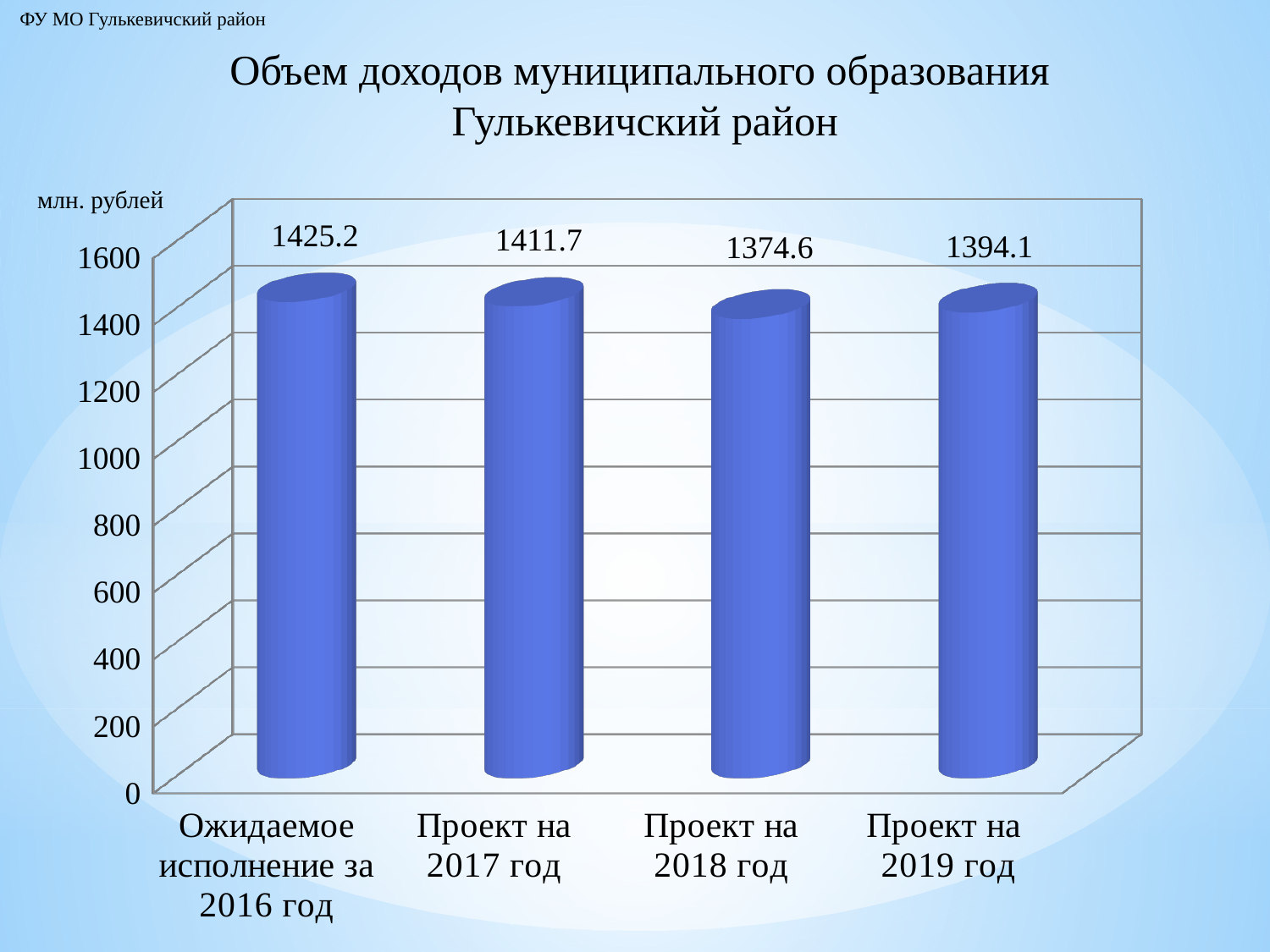
What kind of chart is shown on the slide? bar chart Which is larger: the value for "Проект на 2019 год" or "Проект на 2018 год"? Проект на 2019 год What is the difference between the values for "Ожидаемое исполнение за 2016 год" and "Проект на 2018 год"? 50.6 What is the value for "Проект на 2017 год"? 1411.7 Which category has the highest value? Ожидаемое исполнение за 2016 год What is the value for "Ожидаемое исполнение за 2016 год"? 1425.2 Which category has the lowest value? Проект на 2018 год Is the value for "Проект на 2017 год" greater or less than 1200? greater How many categories are shown on the chart? 4 What unit is indicated for the values on the chart? млн. рублей What is the value for "Проект на 2019 год"? 1394.1 What is the value for "Проект на 2018 год"? 1374.6